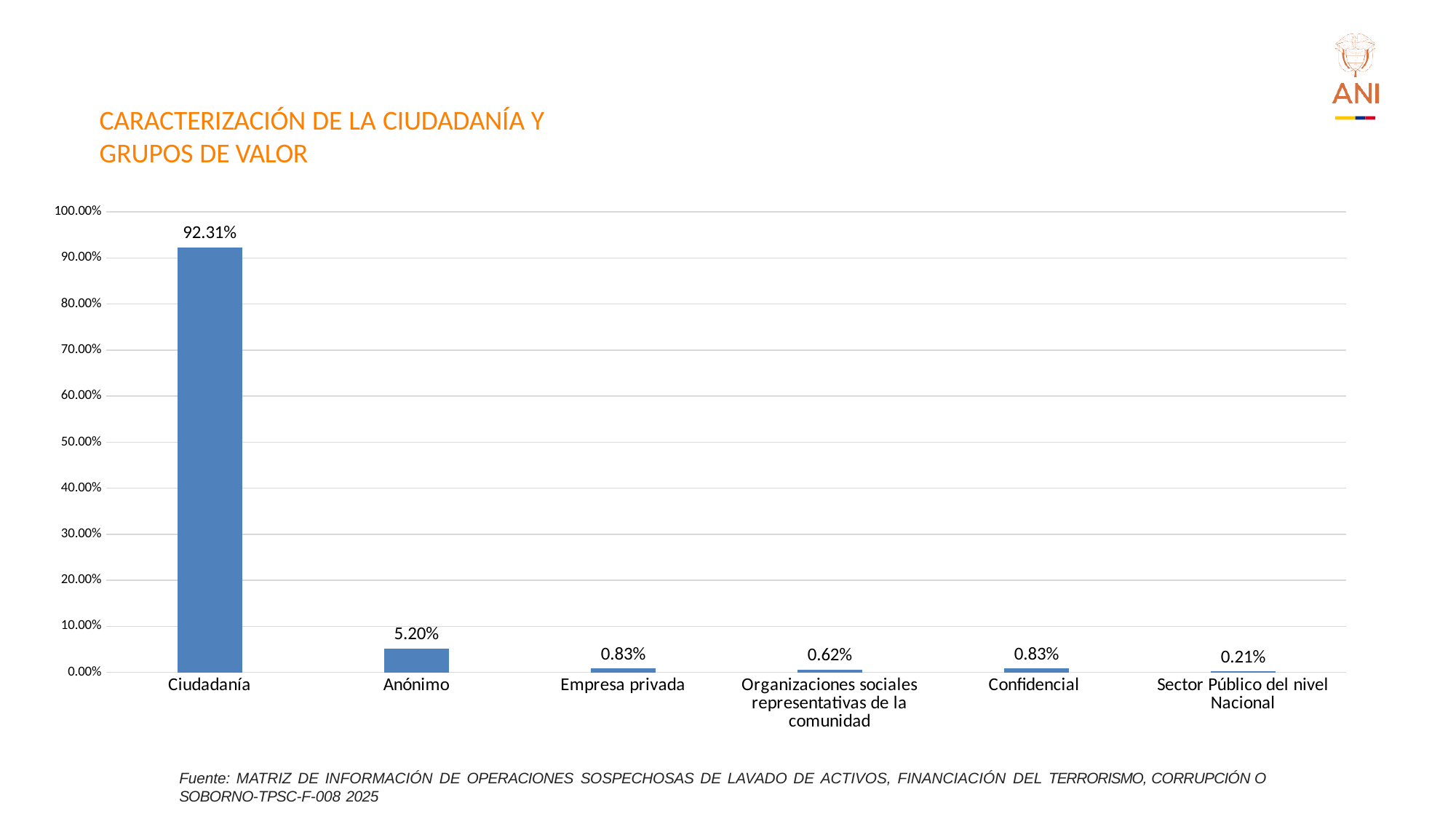
Which category has the lowest value? Sector Público del nivel Nacional Which is larger, the value for Empresa privada or the value for Organizaciones sociales representativas de la comunidad? Empresa privada Which category has the highest value? Ciudadanía What is the value for Confidencial? 0.83% What is the value for Sector Público del nivel Nacional? 0.21% What is the difference between the values for Ciudadanía and Anónimo? 87.11% How many categories are shown on the x axis? 6 What is the value for Anónimo? 5.20% What is the value for Organizaciones sociales representativas de la comunidad? 0.62% Is the value for Ciudadanía greater or less than 90.00%? greater What kind of chart is shown on the slide? Bar chart What is the value for Ciudadanía? 92.31%